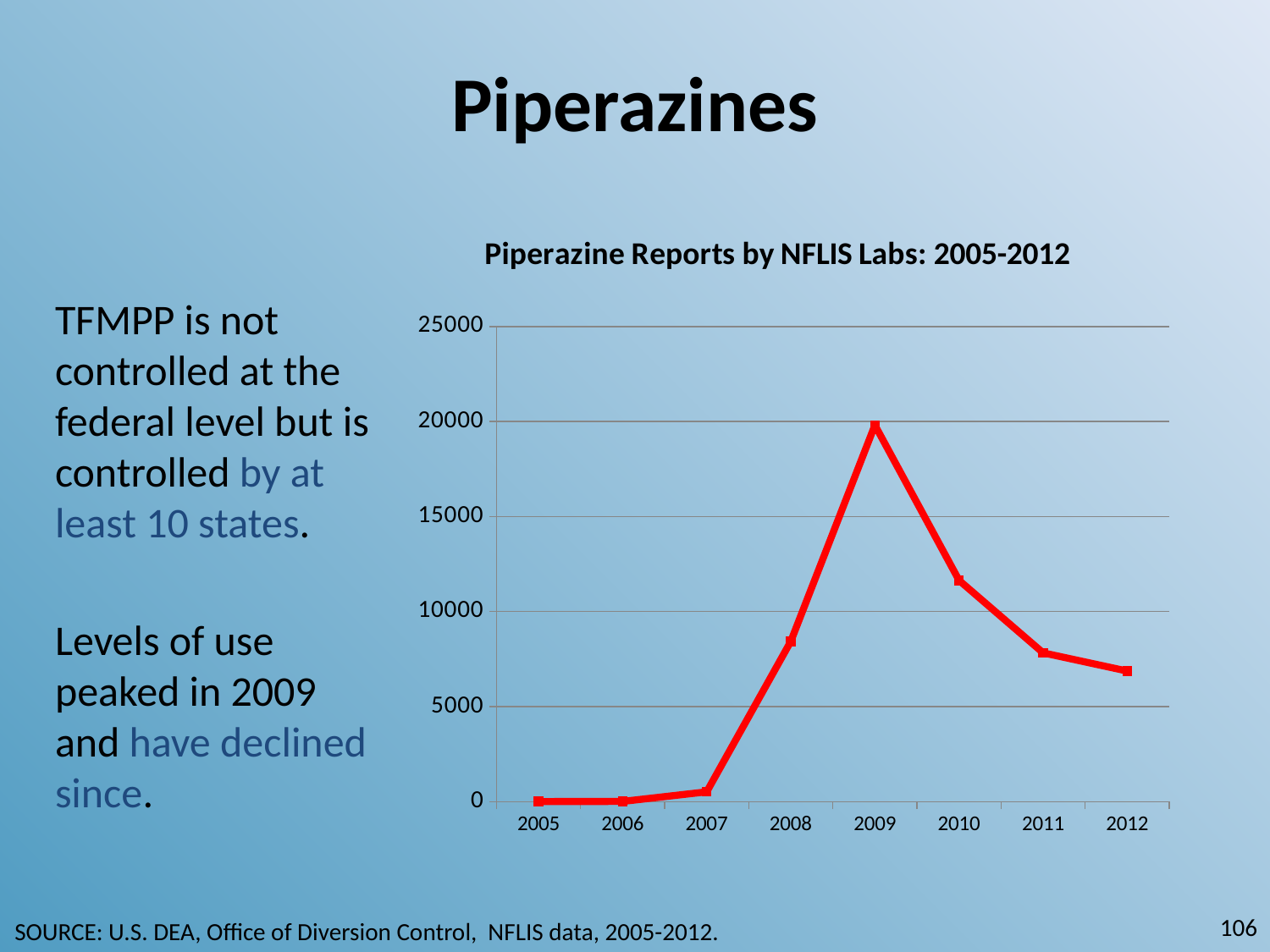
How many years are plotted on the x axis of the chart? 8 Is the value for 2008 greater or less than 10000? less Do the values rise or fall from 2009 to 2012? fall In which year does the chart reach its highest value? 2009 Is the value for 2007 greater or less than 5000? less Which year has the larger value, 2008 or 2010? 2010 What is the title of the chart? Piperazine Reports by NFLIS Labs: 2005-2012 Is the value for 2012 greater or less than 5000? greater What kind of chart is shown on the slide? line chart Do the values rise or fall from 2006 to 2009? rise